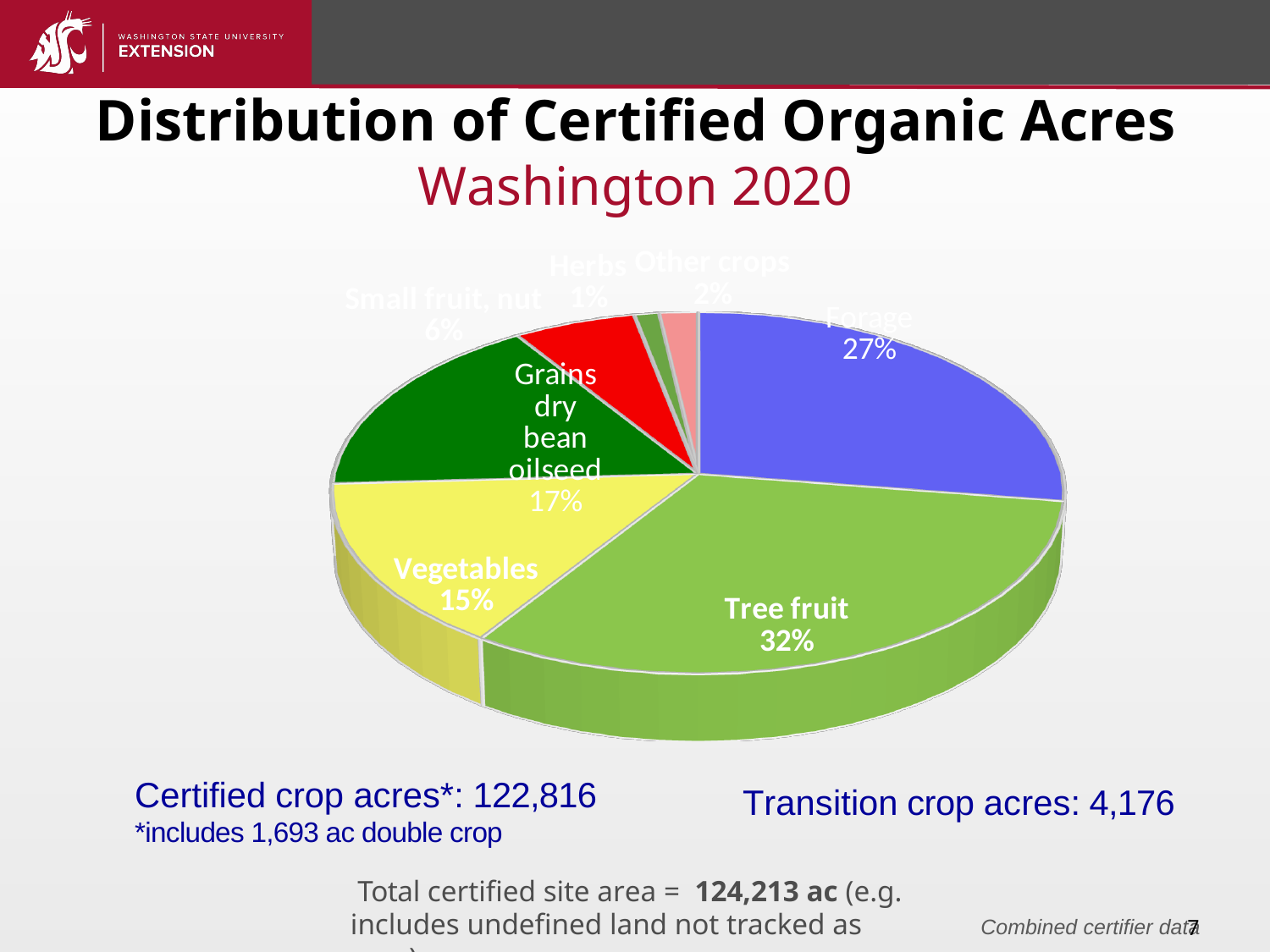
Which has a larger share, Vegetables or Grains dry bean oilseed? Grains dry bean oilseed What percentage is shown for Small fruit, nut? 6% What share of certified organic acres is Forage? 27% What is the difference in percentage points between Tree fruit and Forage? 5 Which category has the largest share of the pie? Tree fruit What percentage is shown for Vegetables? 15% How many categories are shown in the pie chart? 7 Which category has the smallest share of the pie? Herbs What share of certified organic acres is Tree fruit? 32% What percentage is shown for Grains dry bean oilseed? 17% What kind of chart is shown on the slide? pie chart What year does the chart title refer to? 2020